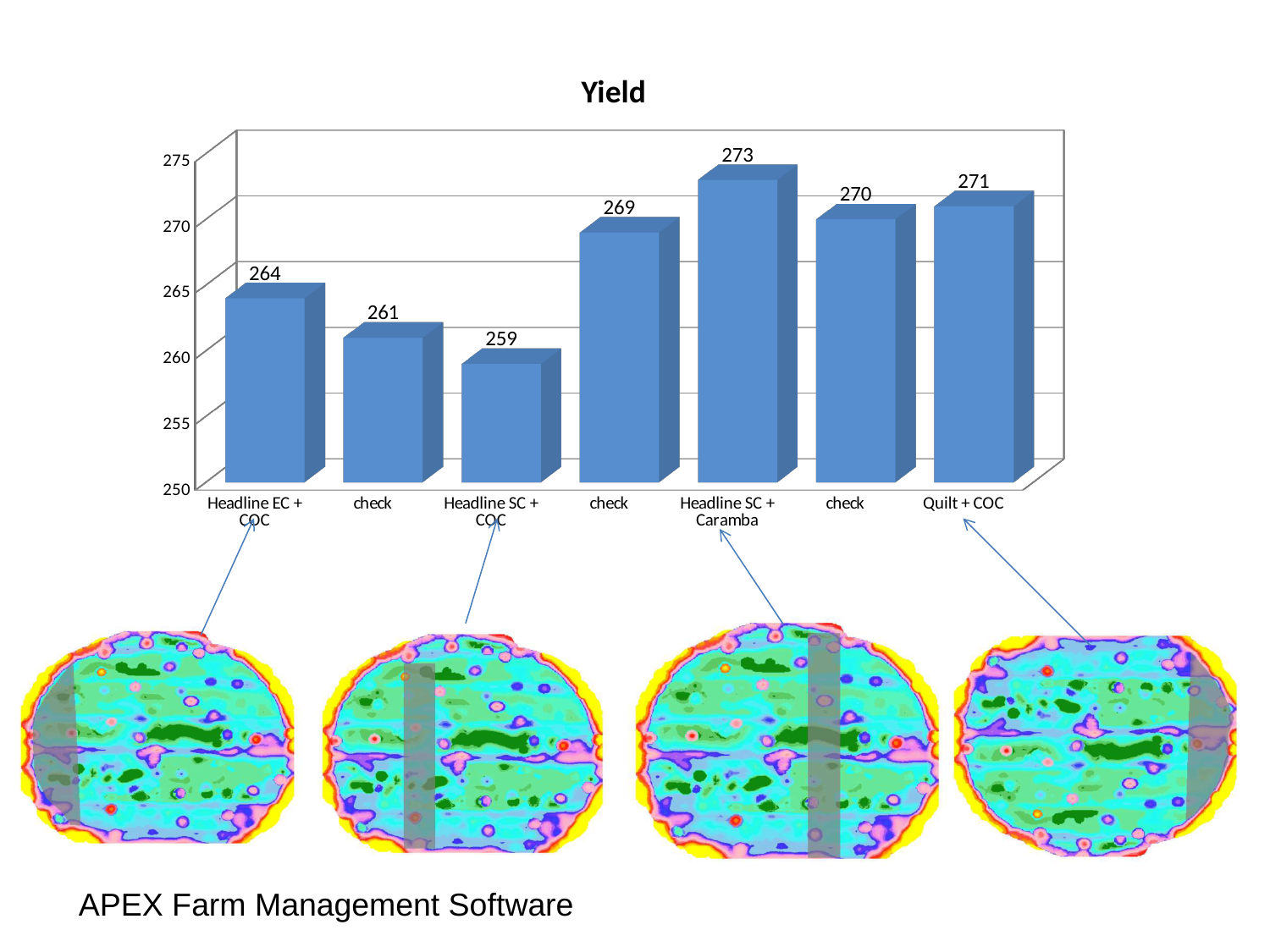
What is the yield value for Quilt + COC? 271 What is the yield value of the check bar immediately to the right of Headline SC + COC? 269 Which has a higher yield, Headline EC + COC or Quilt + COC? Quilt + COC How many bars does the Yield chart have? 7 Which category has the highest yield? Headline SC + Caramba What is the yield value for Headline SC + Caramba? 273 What is the title of the chart? Yield What is the difference in yield between Headline SC + Caramba and Headline SC + COC? 14 What kind of chart is shown on the slide? bar chart What is the yield value for Headline EC + COC? 264 Which category has the lowest yield? Headline SC + COC What is the yield value for Headline SC + COC? 259